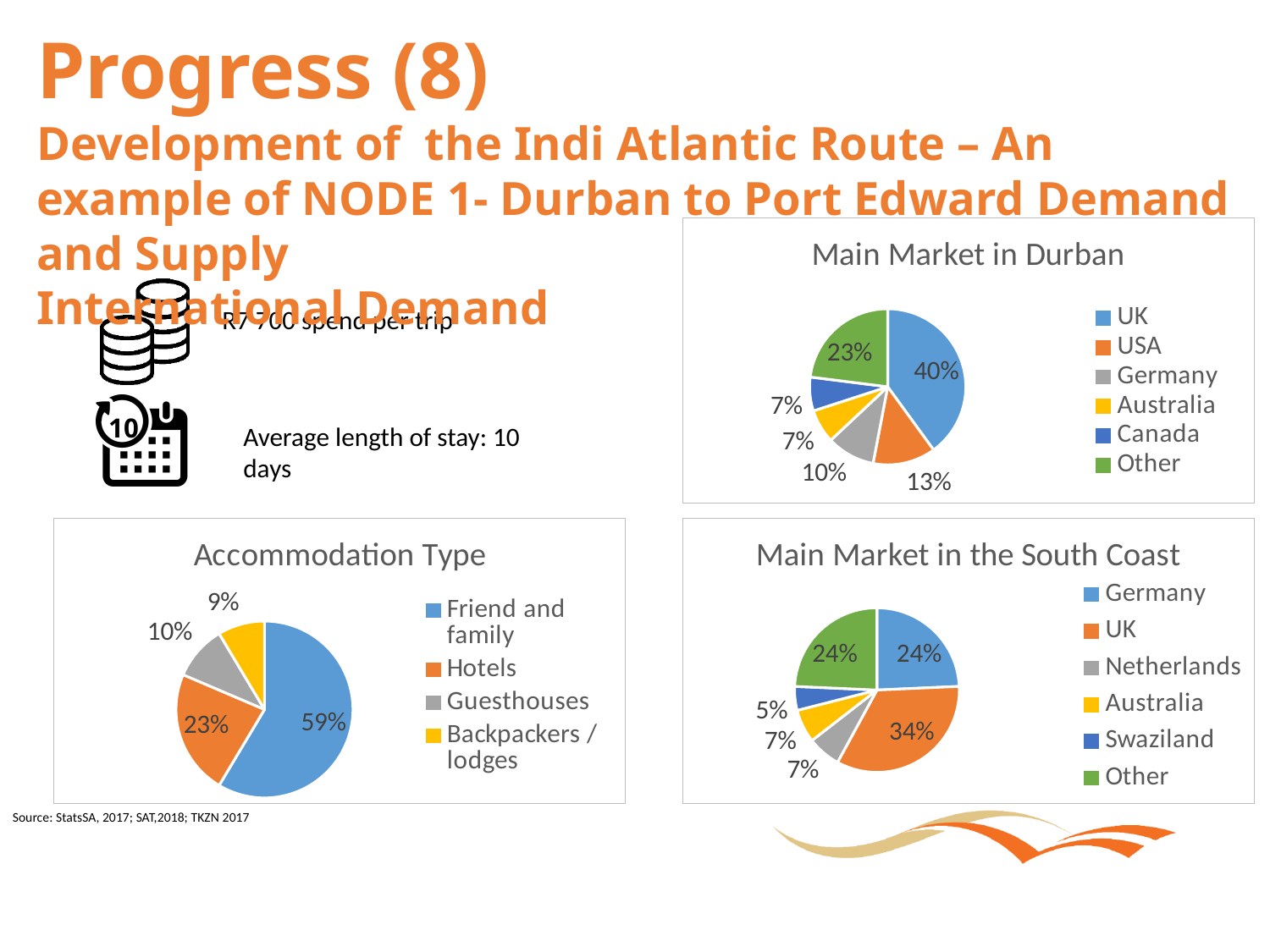
What kind of chart is the 'Accommodation Type' chart? Pie chart In the 'Accommodation Type' chart, what share is Friend and family? 59% In the 'Accommodation Type' chart, which is larger, Hotels or Guesthouses? Hotels In the 'Main Market in the South Coast' chart, what share does the UK hold? 34% In the 'Main Market in Durban' chart, which market has the largest share? UK In the 'Accommodation Type' chart, which accommodation type has the smallest share? Backpackers / lodges In the 'Main Market in the South Coast' chart, what is the difference between the UK share and the Germany share? 10% In the 'Main Market in Durban' chart, how many slices does the legend list? 6 In the 'Main Market in the South Coast' chart, which market has the smallest share? Swaziland In the 'Main Market in Durban' chart, what share does the USA hold? 13% In the 'Main Market in Durban' chart, what share does the UK hold? 40% In the 'Main Market in Durban' chart, what is the difference between the UK share and the Other share? 17%